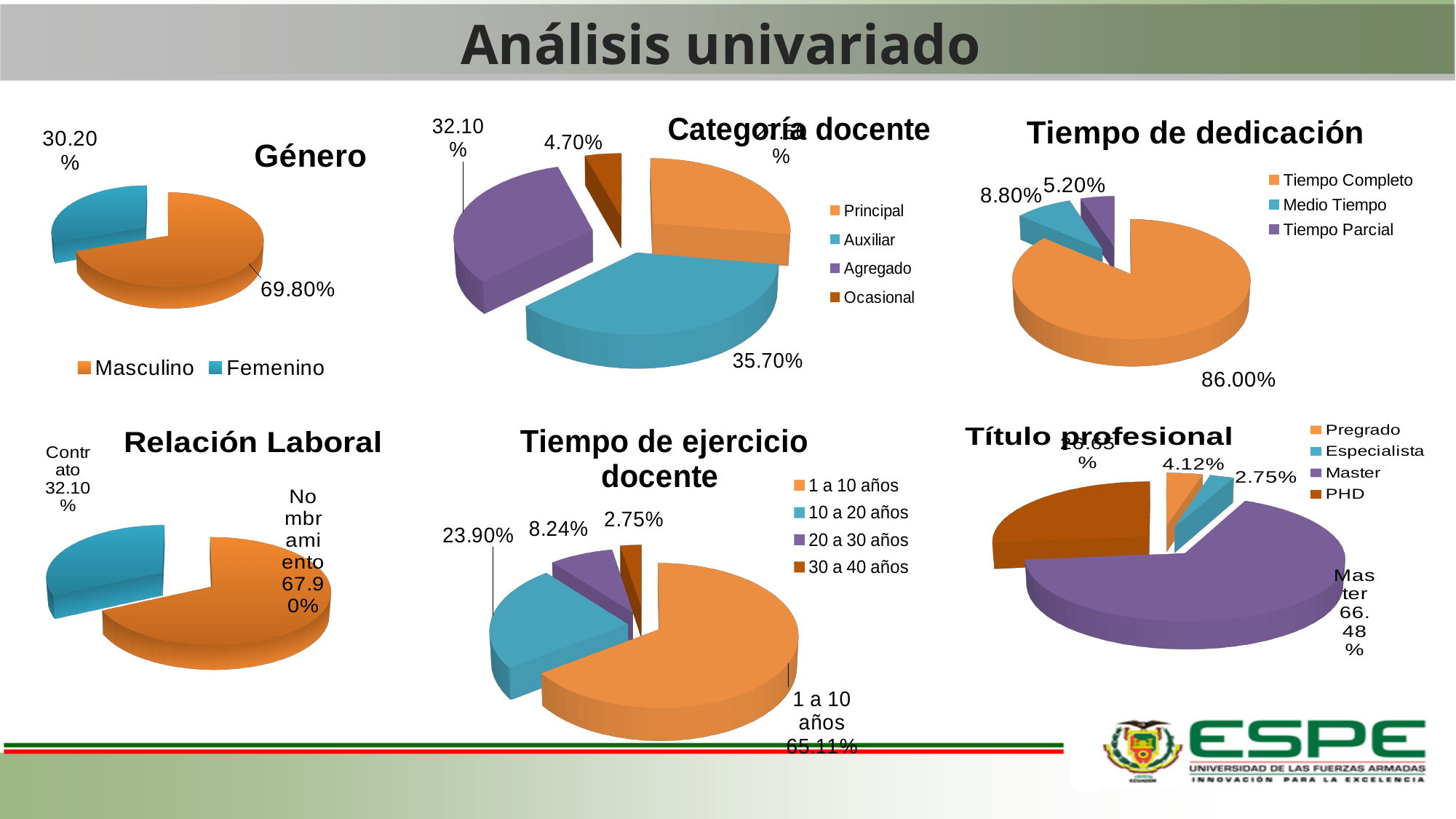
In the Tiempo de ejercicio docente chart, how many categories does the legend list? 4 In the Género chart, what percentage is Masculino? 69.80% In the Tiempo de dedicación chart, what percentage is Tiempo Completo? 86.00% In the Género chart, what percentage is Femenino? 30.20% In the Relación Laboral chart, what percentage is Contrato? 32.10% In the Título profesional chart, what percentage is Master? 66.48% In the Tiempo de dedicación chart, what is the difference between Medio Tiempo and Tiempo Parcial? 3.60% In the Categoría docente chart, which category has the smallest share? Ocasional What type of chart is the Género chart? Pie chart In the Categoría docente chart, what percentage is Auxiliar? 35.70% In the Tiempo de ejercicio docente chart, what percentage is 10 a 20 años? 23.90% In the Relación Laboral chart, which is larger, Nombramiento or Contrato? Nombramiento